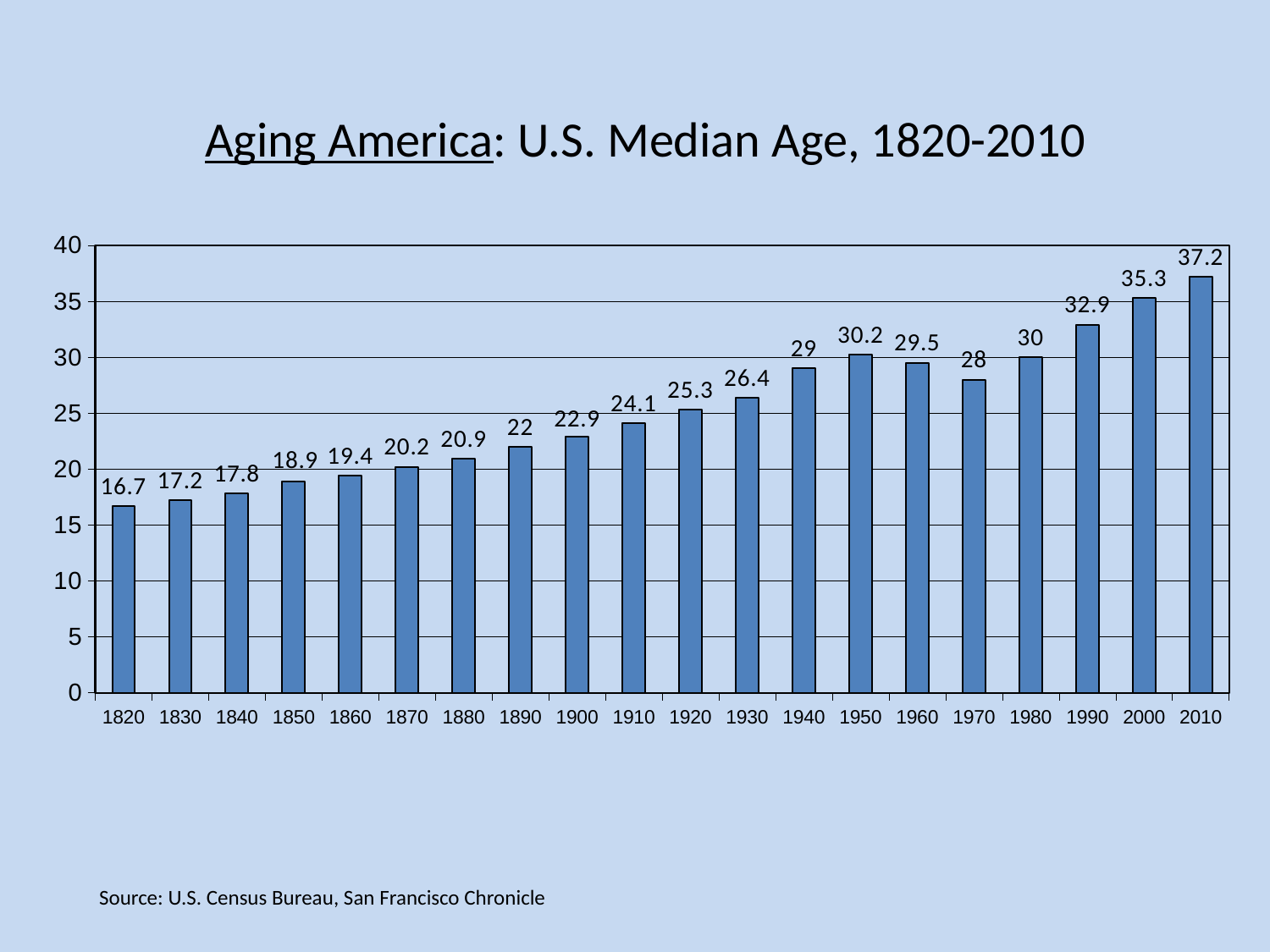
Which year has a higher median age, 1950 or 1960? 1950 What is the U.S. median age shown for 1950? 30.2 What is the difference between the median age in 1960 and in 1970? 1.5 Which year has the lowest median age on the chart? 1820 What is the U.S. median age shown for 2010? 37.2 Which year has the highest median age on the chart? 2010 What is the U.S. median age shown for 1820? 16.7 Is the median age for 1940 greater or less than 25? greater What is the source cited for the chart data? U.S. Census Bureau, San Francisco Chronicle What kind of chart is shown on the slide? bar chart What is the difference between the median age in 2010 and in 1820? 20.5 How many years (bars) are shown on the chart? 20